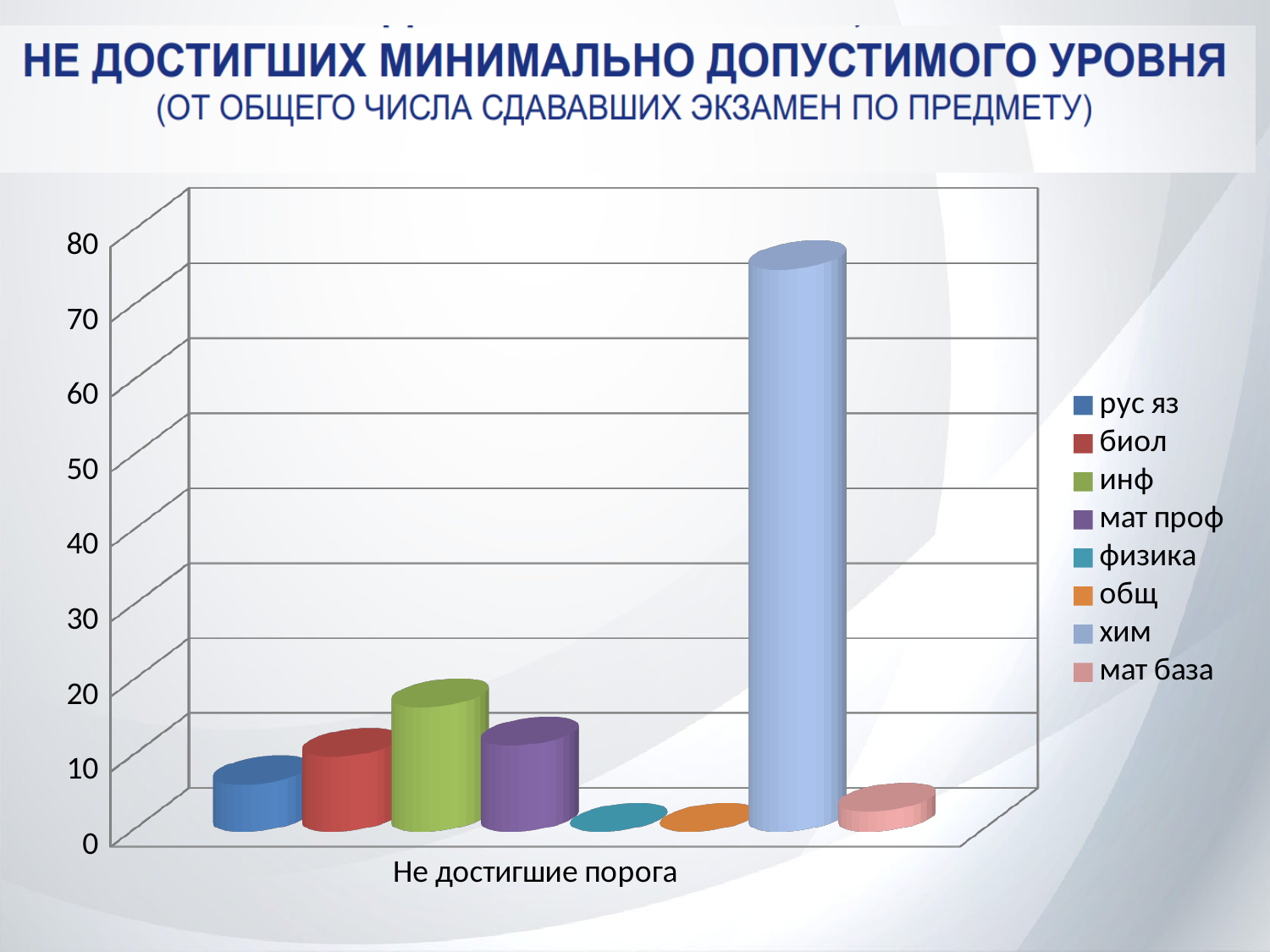
Which is larger, the value for хим or the value for инф? хим Which is larger, the value for инф or the value for рус яз? инф How many series does the legend list? 8 Which series has the highest value? хим How many categories are shown on the x axis? 1 Is the value for хим greater or less than 60? greater Is the value for рус яз greater or less than 20? less What is the category label shown on the x axis? Не достигшие порога Is the value for инф greater or less than 30? less Which is larger, the value for мат проф or the value for инф? инф What kind of chart is shown on the slide? bar chart